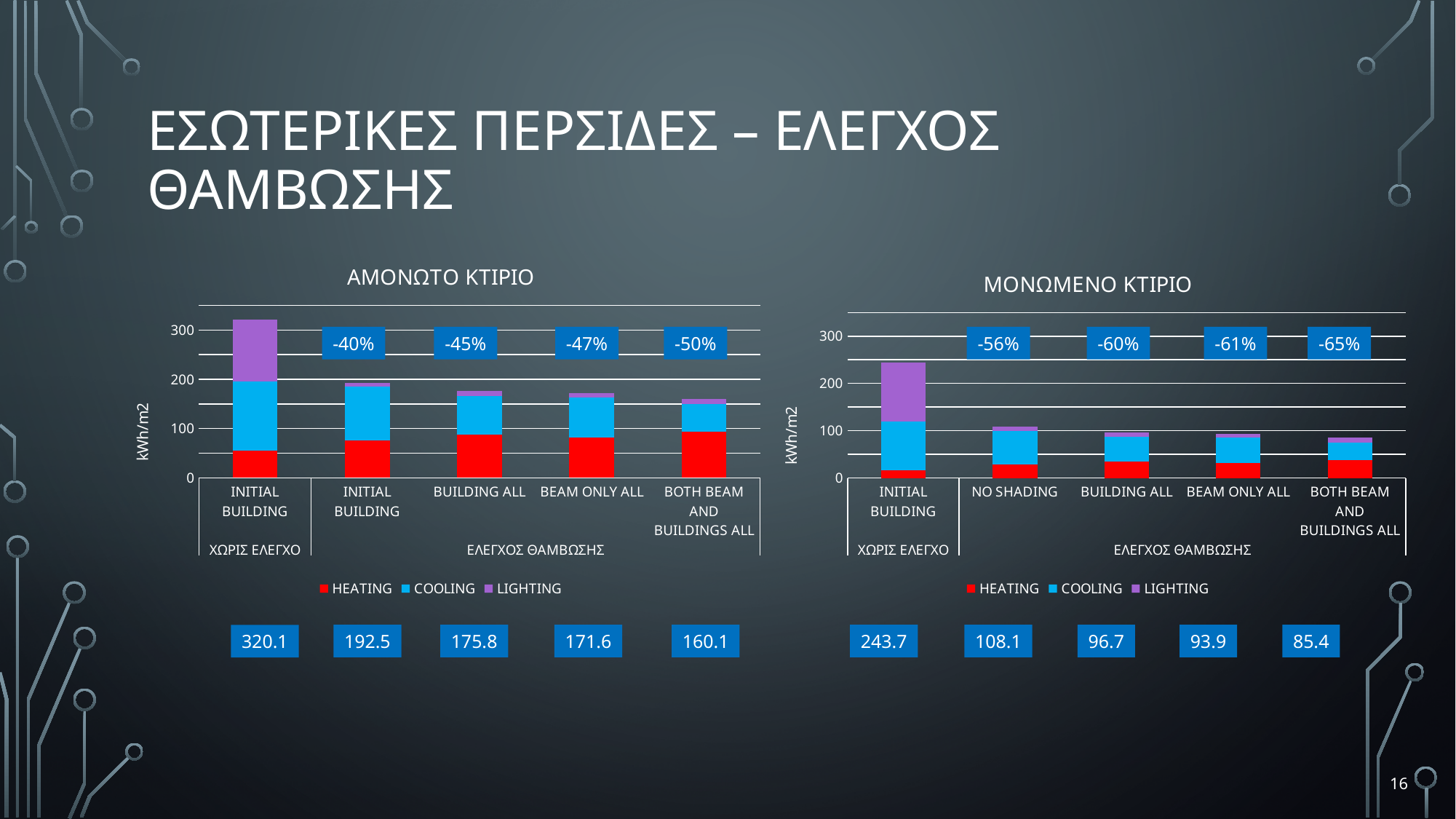
In the ΜΟΝΩΜΕΝΟ ΚΤΙΡΙΟ chart, do the bar totals rise or fall from left to right? fall Which is larger: the BEAM ONLY ALL total in the ΑΜΟΝΩΤΟ ΚΤΙΡΙΟ chart or the NO SHADING total in the ΜΟΝΩΜΕΝΟ ΚΤΙΡΙΟ chart? BEAM ONLY ALL in the ΑΜΟΝΩΤΟ ΚΤΙΡΙΟ chart (171.6) In the ΜΟΝΩΜΕΝΟ ΚΤΙΡΙΟ chart, what is the difference between the INITIAL BUILDING total (243.7) and the BOTH BEAM AND BUILDINGS ALL total (85.4)? 158.3 In the ΜΟΝΩΜΕΝΟ ΚΤΙΡΙΟ chart, what is the total value printed for BOTH BEAM AND BUILDINGS ALL? 85.4 In the ΑΜΟΝΩΤΟ ΚΤΙΡΙΟ chart, is the HEATING value for INITIAL BUILDING under ΧΩΡΙΣ ΕΛΕΓΧΟ greater or less than 100? less In the ΜΟΝΩΜΕΝΟ ΚΤΙΡΙΟ chart, which category has the highest total? INITIAL BUILDING (ΧΩΡΙΣ ΕΛΕΓΧΟ) How many series does the legend of the ΜΟΝΩΜΕΝΟ ΚΤΙΡΙΟ chart list? 3 In the ΑΜΟΝΩΤΟ ΚΤΙΡΙΟ chart, what is the total value printed for INITIAL BUILDING under ΧΩΡΙΣ ΕΛΕΓΧΟ? 320.1 In the ΑΜΟΝΩΤΟ ΚΤΙΡΙΟ chart, which category has the lowest total? BOTH BEAM AND BUILDINGS ALL In the ΑΜΟΝΩΤΟ ΚΤΙΡΙΟ chart, what percentage change is shown above the BUILDING ALL bar? -45% How many bars are plotted in the ΑΜΟΝΩΤΟ ΚΤΙΡΙΟ chart? 5 What kind of chart is the ΑΜΟΝΩΤΟ ΚΤΙΡΙΟ chart on the left? Stacked bar chart